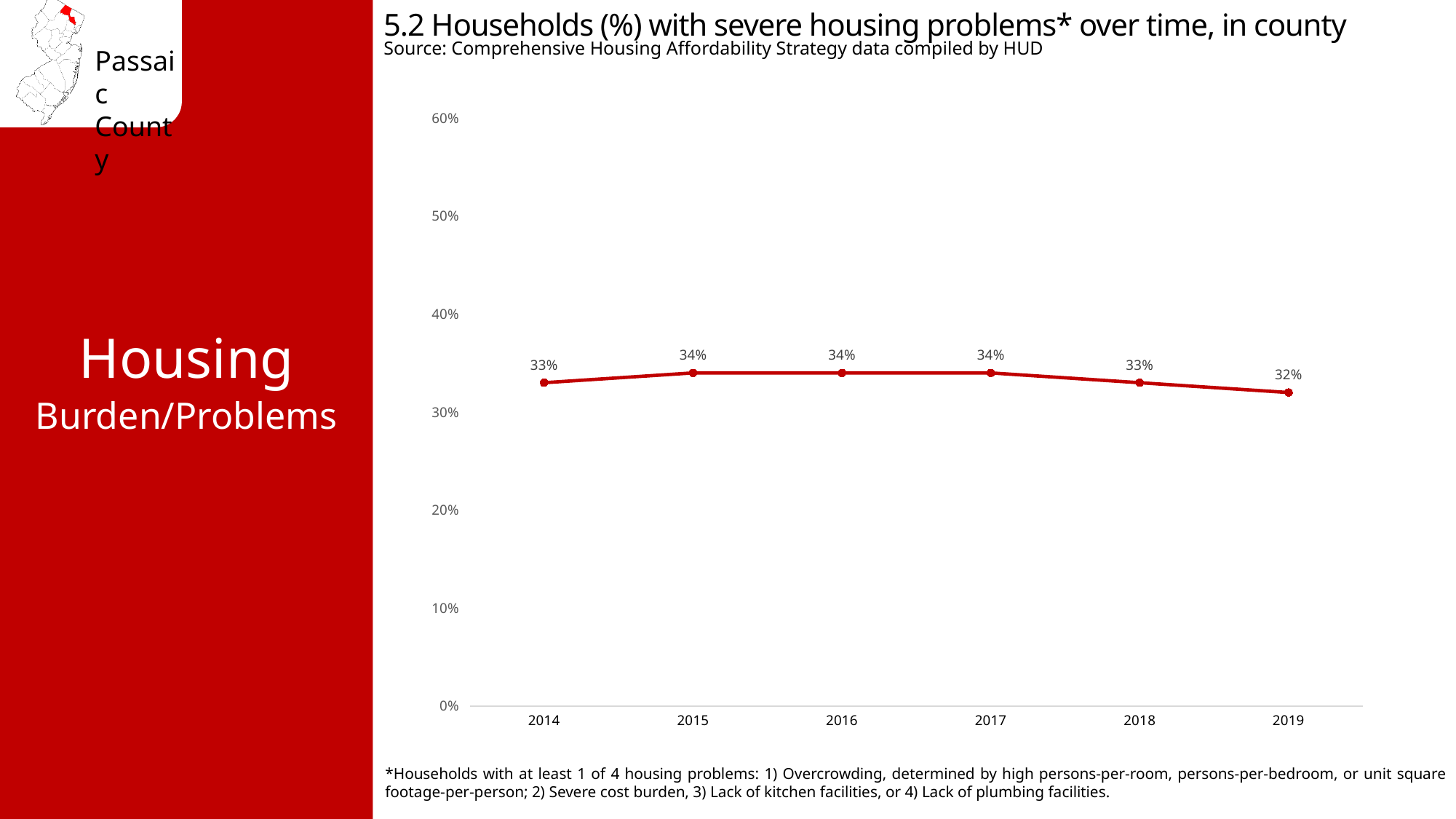
How many years are plotted on the chart? 6 What is the difference between the 2015 value and the 2019 value? 2% Does the value rise or fall from 2017 to 2019? fall What is the value shown for 2019? 32% Is the value for 2016 greater or less than 40%? less What percentage of households had severe housing problems in 2014? 33% Is the value for 2018 larger or smaller than the value for 2016? smaller What is the title of the chart? 5.2 Households (%) with severe housing problems* over time, in county What is the source of the data shown in the chart? Comprehensive Housing Affordability Strategy data compiled by HUD Which year has the lowest percentage of households with severe housing problems? 2019 What kind of chart is shown on the slide? line chart What percentage is shown for 2017? 34%